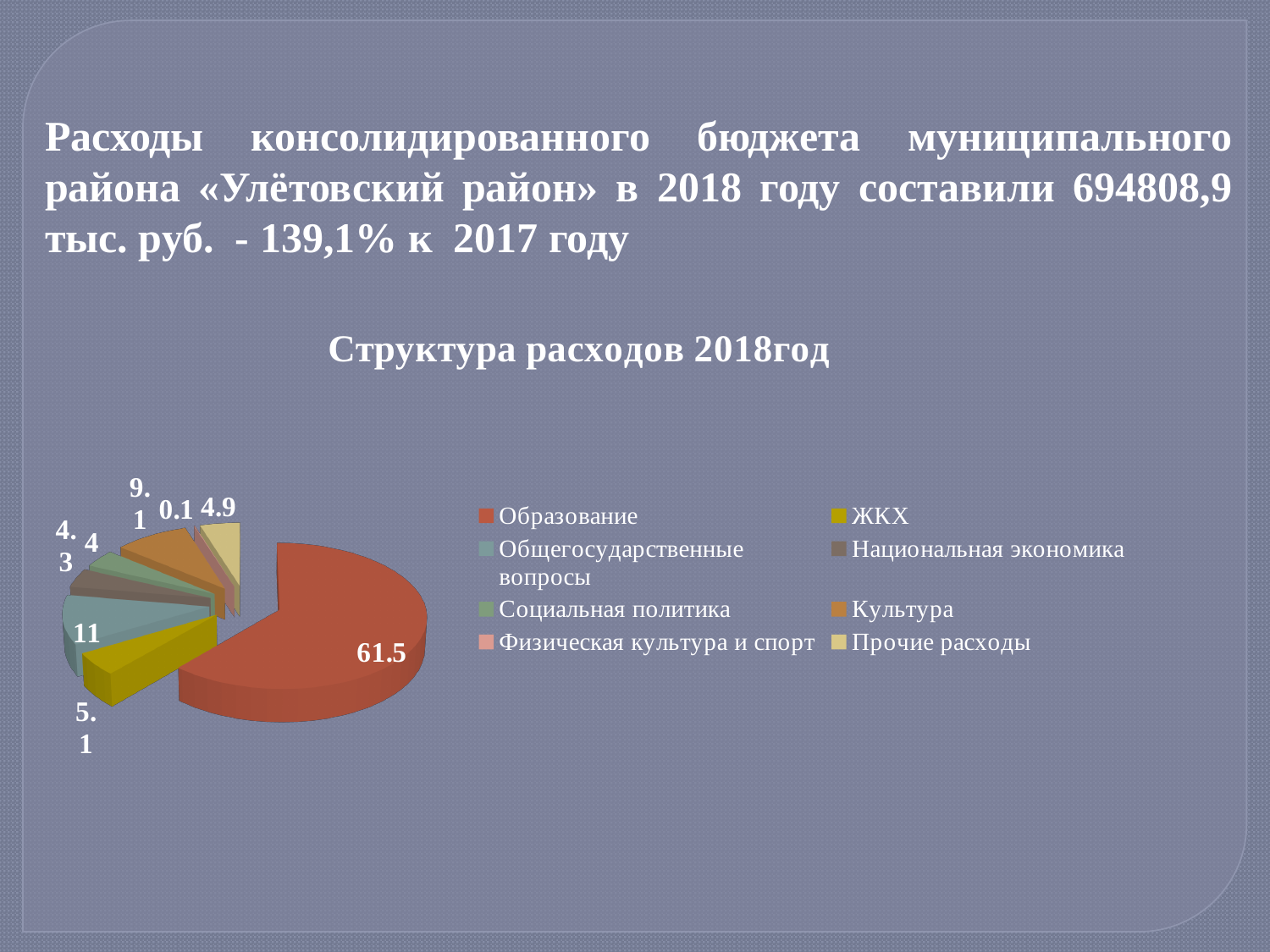
Which is larger, the value for Культура or the value for ЖКХ? Культура Which category has the smallest slice of the pie? Физическая культура и спорт What is the value shown for Физическая культура и спорт? 0.1 What is the value shown for Образование? 61.5 Which category has the largest slice of the pie? Образование What is the value shown for Прочие расходы? 4.9 How many categories does the legend list? 8 What is the difference between the values for Образование and Общегосударственные вопросы? 50.5 What type of chart is shown on the slide? pie chart What is the title of the chart? Структура расходов 2018год What is the value shown for Культура? 9.1 What is the value shown for Общегосударственные вопросы? 11